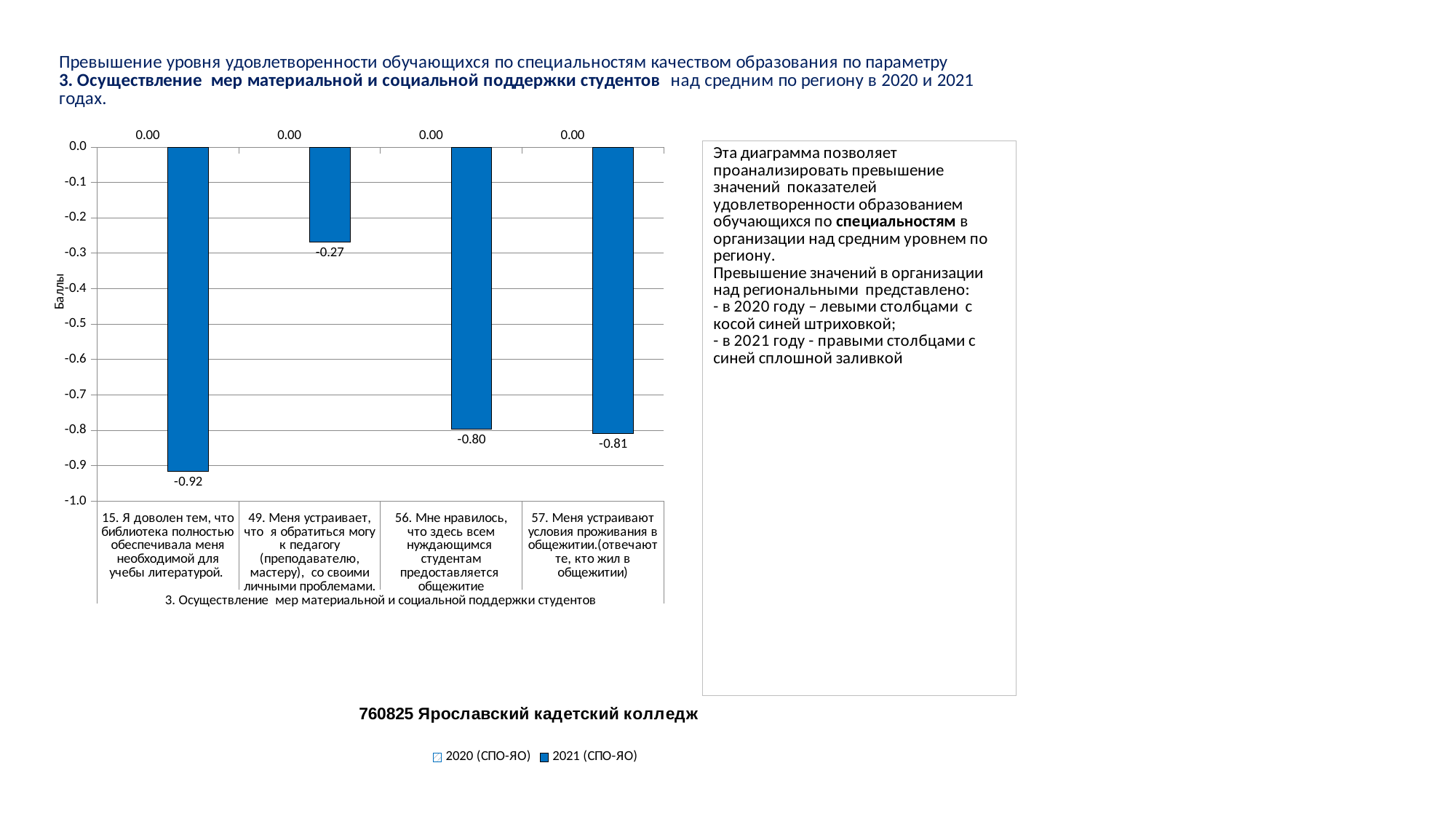
What type of chart is shown on the slide? Bar chart How many series does the chart legend list? 2 Which category has the lowest 2021 (СПО-ЯО) value? 15. Я доволен тем, что библиотека полностью обеспечивала меня необходимой для учебы литературой. What is the 2021 (СПО-ЯО) value for category 15 (Я доволен тем, что библиотека полностью обеспечивала меня необходимой для учебы литературой)? -0.92 What is the difference between the 2021 (СПО-ЯО) values for category 15 and category 49? 0.65 How many categories are shown on the x axis of the chart? 4 What is the 2021 (СПО-ЯО) value for category 56 (Мне нравилось, что здесь всем нуждающимся студентам предоставляется общежитие)? -0.80 What is the 2021 (СПО-ЯО) value for category 49 (Меня устраивает, что я обратиться могу к педагогу со своими личными проблемами)? -0.27 Which is larger, the 2021 (СПО-ЯО) value for category 49 or for category 56? Category 49 (-0.27) What is the 2021 (СПО-ЯО) value for category 57 (Меня устраивают условия проживания в общежитии)? -0.81 What is the 2020 (СПО-ЯО) value for category 15? 0.00 Which category has the highest 2021 (СПО-ЯО) value? 49. Меня устраивает, что я обратиться могу к педагогу (преподавателю, мастеру), со своими личными проблемами.